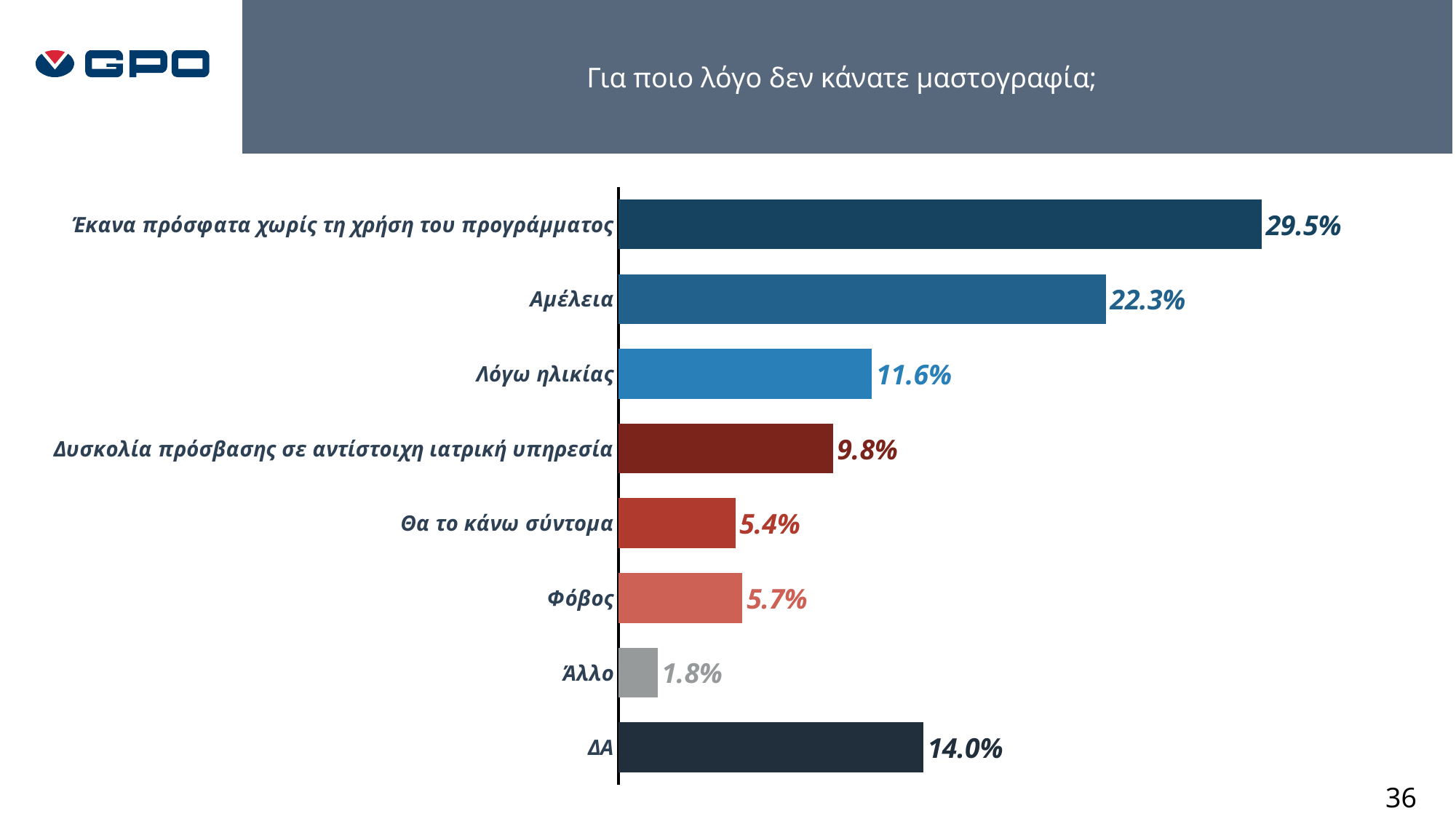
What is the value for Λόγω ηλικίας? 11.6% How many categories are shown in the chart? 8 What is the value for ΔΑ? 14.0% What is the value for Φόβος? 5.7% Which is larger, the value for Λόγω ηλικίας or the value for ΔΑ? ΔΑ What kind of chart is shown on the slide? Bar chart What is the difference between the values for Έκανα πρόσφατα χωρίς τη χρήση του προγράμματος and Αμέλεια? 7.2% Which category has the lowest value? Άλλο Which category has the highest value? Έκανα πρόσφατα χωρίς τη χρήση του προγράμματος What is the title of the chart? Για ποιο λόγο δεν κάνατε μαστογραφία; What is the difference between the values for ΔΑ and Δυσκολία πρόσβασης σε αντίστοιχη ιατρική υπηρεσία? 4.2% What is the value for Αμέλεια? 22.3%